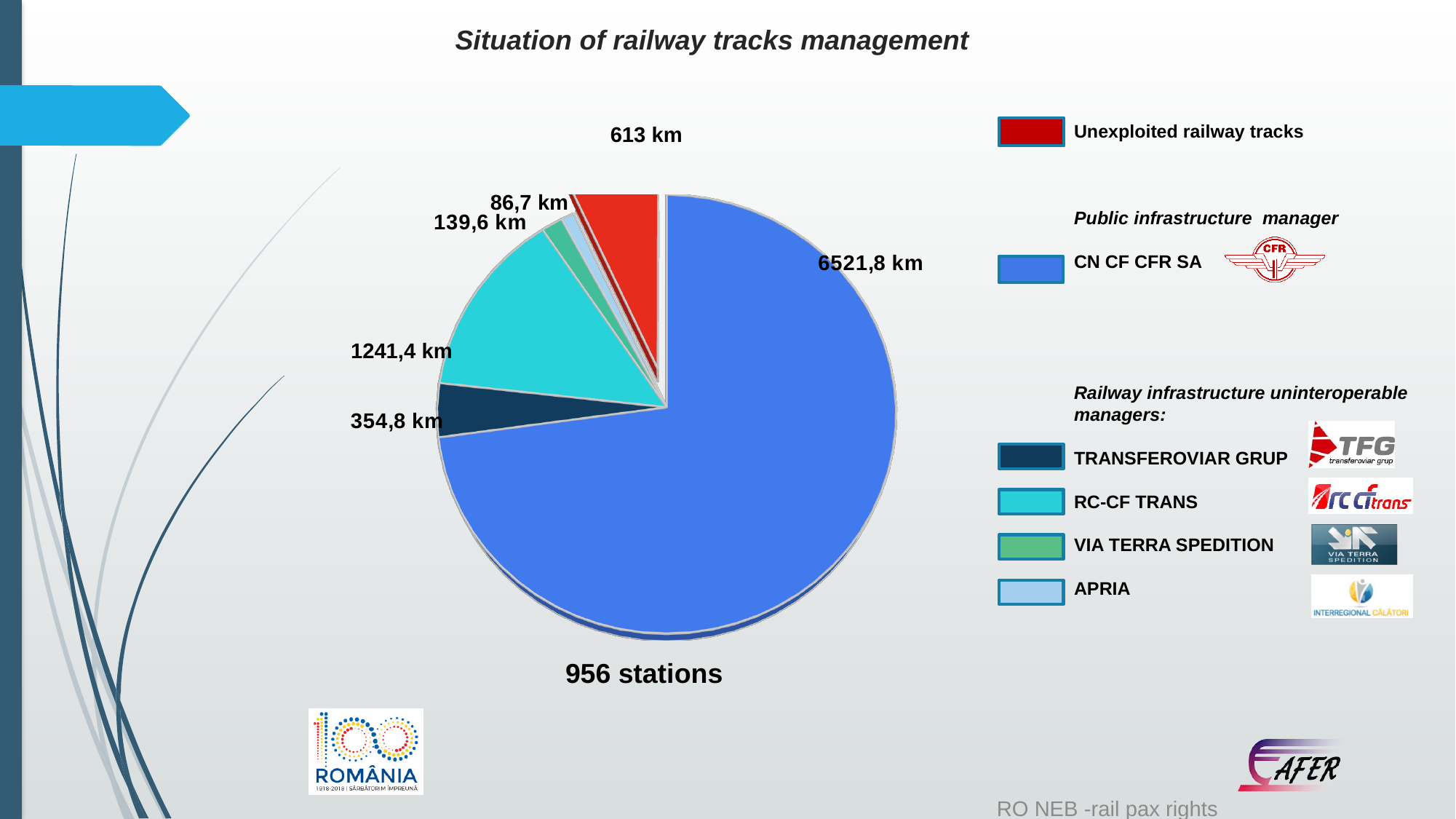
What is the value for Unexploited railway tracks in the pie chart? 613 km Which category has the smallest slice in the pie chart? APRIA What is the value for TRANSFEROVIAR GRUP in the pie chart? 354,8 km What type of chart is shown on the slide? pie chart Which is larger, the value for VIA TERRA SPEDITION or the value for APRIA? VIA TERRA SPEDITION What is the difference between the values for Unexploited railway tracks and TRANSFEROVIAR GRUP? 258,2 km What is the value for CN CF CFR SA in the pie chart? 6521,8 km What is the title of the slide's chart? Situation of railway tracks management What is the value for APRIA in the pie chart? 86,7 km What is the value for RC-CF TRANS in the pie chart? 1241,4 km Which category has the largest slice in the pie chart? CN CF CFR SA How many entries does the legend of the pie chart list? 6